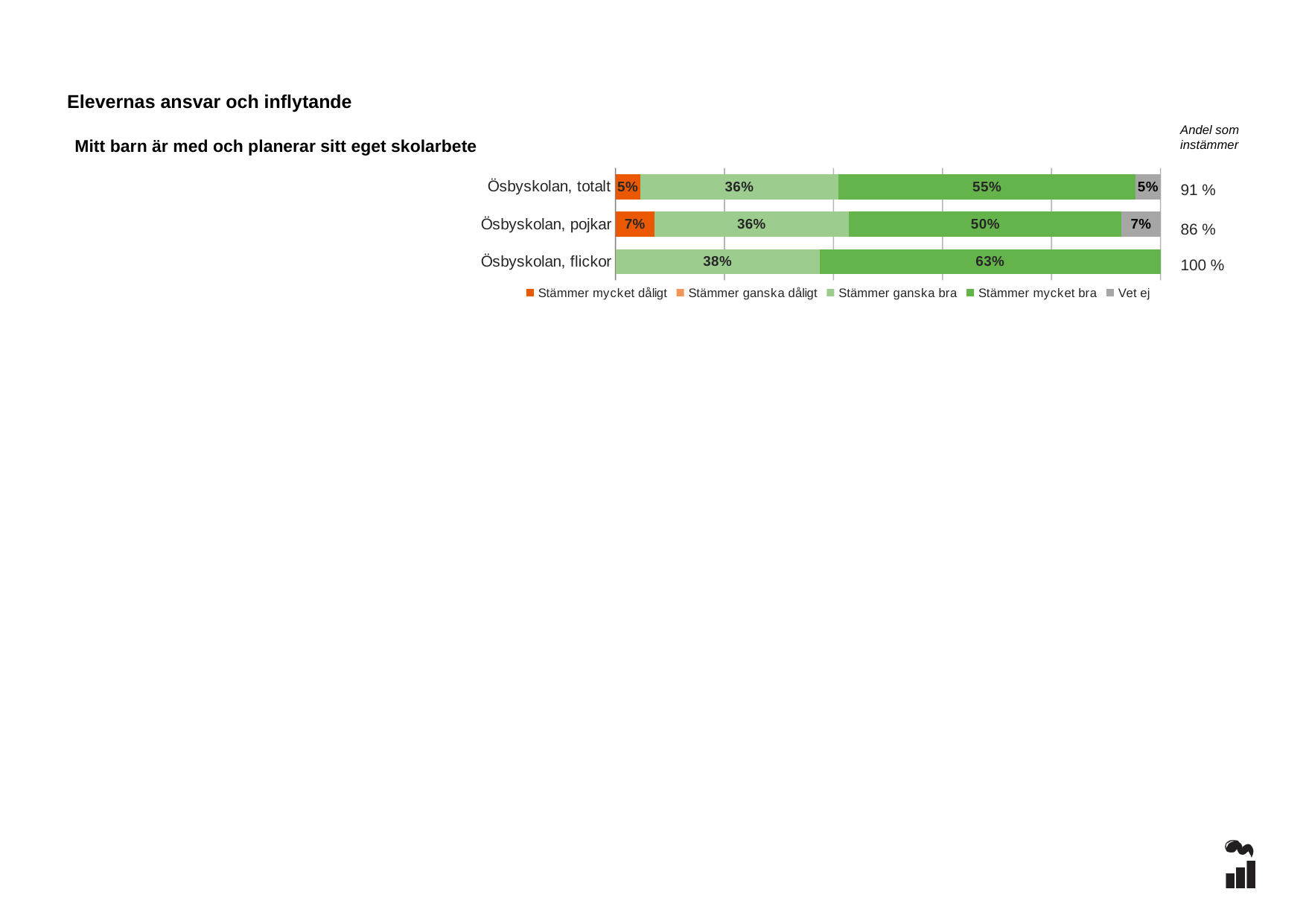
What kind of chart is shown on the slide? Stacked bar chart What is the 'Stämmer mycket dåligt' value for Ösbyskolan, totalt? 5% How many categories (rows) does the chart show? 3 What is the 'Stämmer ganska bra' value for Ösbyskolan, flickor? 38% Which is larger: the 'Stämmer mycket dåligt' value for Ösbyskolan, pojkar or for Ösbyskolan, totalt? Ösbyskolan, pojkar Which category has the highest 'Stämmer mycket bra' value? Ösbyskolan, flickor What is the 'Stämmer mycket bra' value for Ösbyskolan, totalt? 55% Which category has the lowest 'Stämmer mycket bra' value? Ösbyskolan, pojkar How many series does the legend list? 5 What is the 'Vet ej' value for Ösbyskolan, pojkar? 7% What is the difference between the 'Stämmer mycket bra' values for Ösbyskolan, flickor and Ösbyskolan, pojkar? 13 percentage points What is the 'Andel som instämmer' figure shown for Ösbyskolan, pojkar? 86 %